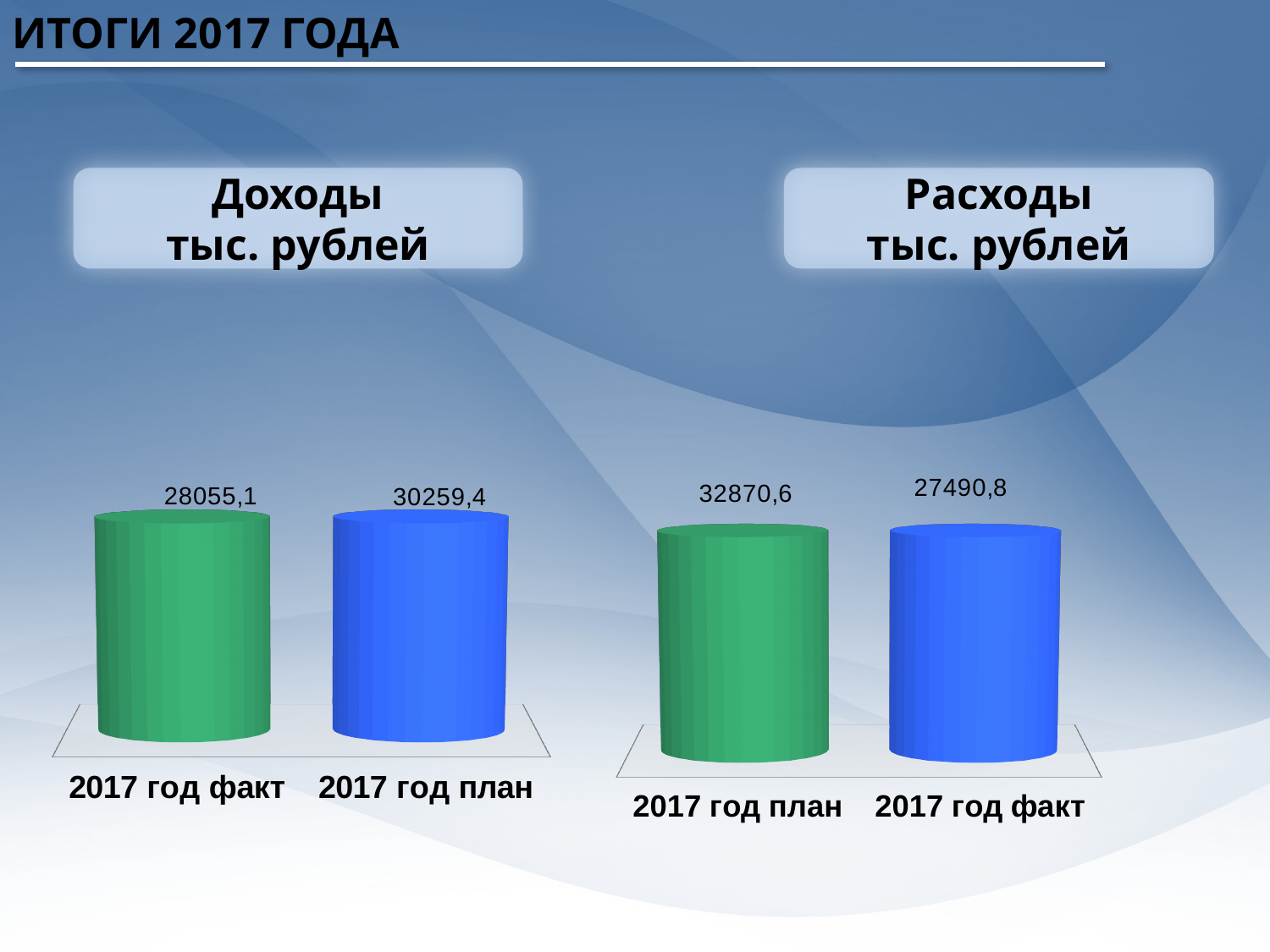
In the right chart (Расходы тыс. рублей), what is the value for 2017 год план? 32870,6 In the right chart (Расходы тыс. рублей), what is the difference between 2017 год план and 2017 год факт? 5379,8 In the left chart (Доходы тыс. рублей), what is the difference between 2017 год план and 2017 год факт? 2204,3 What is the title of the left chart? Доходы тыс. рублей In the right chart (Расходы тыс. рублей), what is the value for 2017 год факт? 27490,8 In the left chart (Доходы тыс. рублей), which category has the higher value? 2017 год план In the left chart (Доходы тыс. рублей), what is the value for 2017 год факт? 28055,1 In the left chart (Доходы тыс. рублей), what is the value for 2017 год план? 30259,4 What kind of chart is the right chart (Расходы тыс. рублей)? Bar chart How many categories are shown in the left chart (Доходы тыс. рублей)? 2 In the right chart (Расходы тыс. рублей), which is larger: 2017 год план or 2017 год факт? 2017 год план In the right chart (Расходы тыс. рублей), which category has the lower value? 2017 год факт